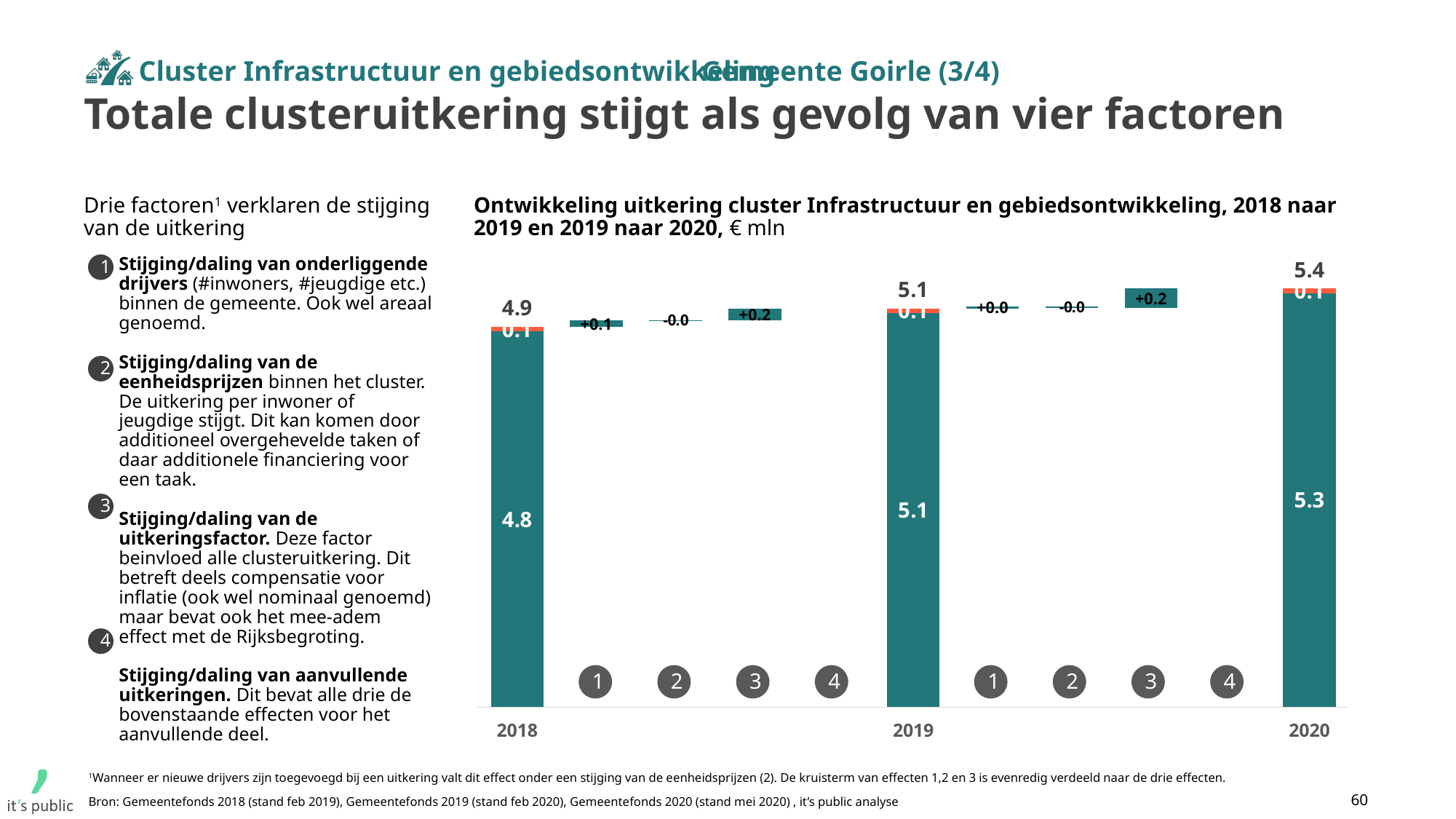
What is the total cluster payment shown above the 2019 bar? 5.1 What is the value of the large teal segment of the 2018 bar? 4.8 What is the value labelled on the factor 3 bar between 2019 and 2020? +0.2 What is the value of the large teal segment of the 2020 bar? 5.3 What is the difference between the 2020 total (5.4) and the 2018 total (4.9)? 0.5 What is the value labelled on the factor 3 bar between 2018 and 2019? +0.2 What is the total cluster payment shown above the 2018 bar? 4.9 What is the total cluster payment shown above the 2020 bar? 5.4 Do the total cluster payments rise or fall from 2018 to 2020? rise What is the value labelled on the factor 1 bar between 2018 and 2019? +0.1 Which year has the lowest total cluster payment? 2018 Which year has the highest total cluster payment? 2020